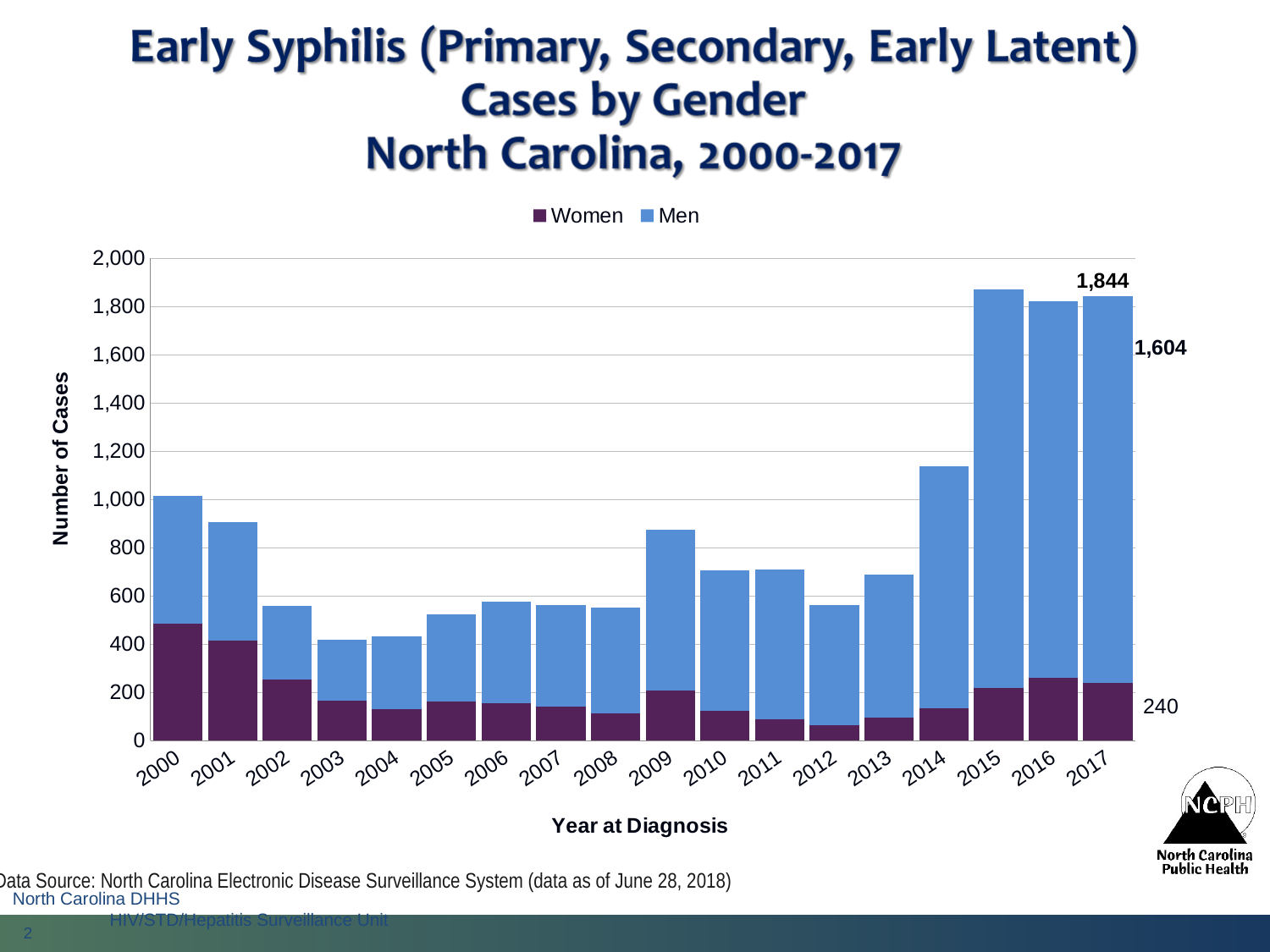
Which year has the lowest number of cases among women? 2012 Which year has a larger total number of cases, 2009 or 2010? 2009 Is the total number of cases for 2014 greater or less than 1,000? greater Which year has the highest number of cases among women? 2000 How many early syphilis cases among men are shown for 2017? 1,604 How many early syphilis cases among women are shown for 2017? 240 What kind of chart is shown on the slide? bar chart In 2017, how many more cases were there among men than among women? 1,364 What is the total number of early syphilis cases shown for 2017? 1,844 How many series does the legend list? 2 How many years are shown along the x axis? 18 What is the title of the y axis? Number of Cases